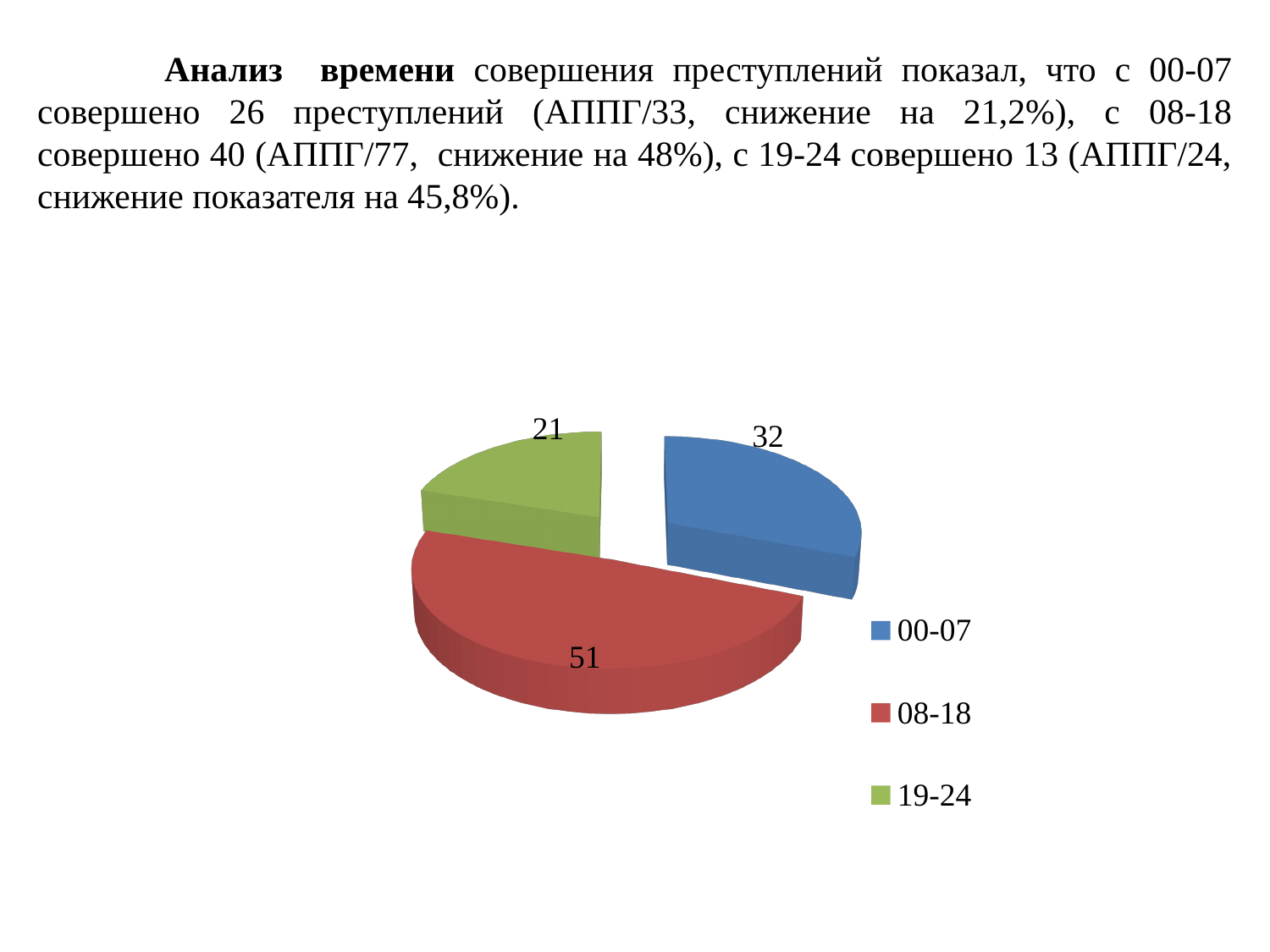
How many slices does the pie chart have? 3 What type of chart is shown on the slide? pie chart Which time period has the smallest slice of the pie? 19-24 What is the value shown for the 19-24 slice? 21 What colour is the slice for 08-18? red What is the difference between the values for 00-07 and 19-24? 11 What is the difference between the values for 08-18 and 00-07? 19 Which time period has the largest slice of the pie? 08-18 What is the value shown for the 00-07 slice? 32 What is the value shown for the 08-18 slice? 51 Which is larger, the value for 00-07 or the value for 19-24? 00-07 What is the total of all the slice values in the pie chart? 104